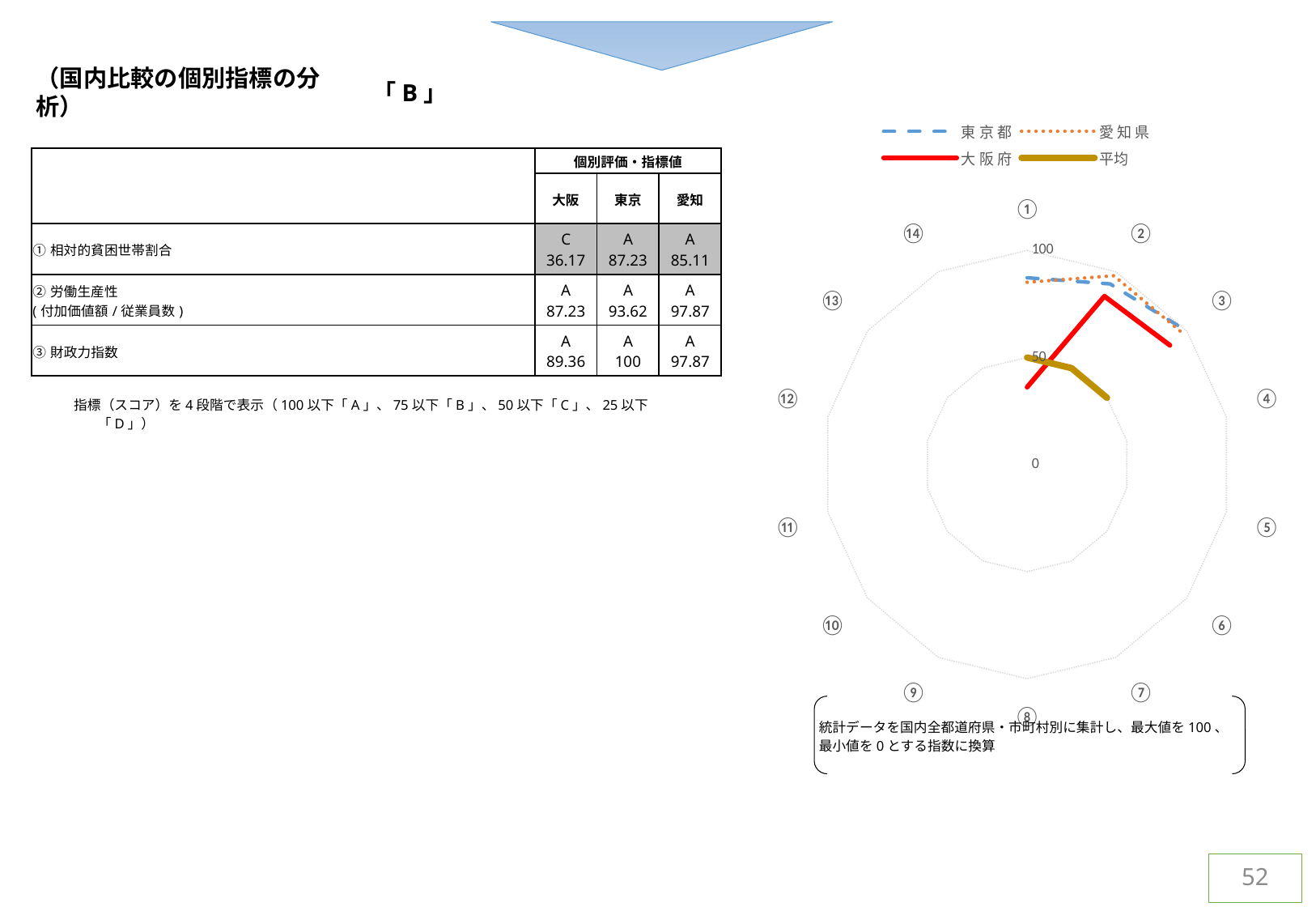
How many numbered axes (categories) does the radar chart have? 14 In the radar chart, which series has the larger value at axis ③: 東京都 or 大阪府? 東京都 What kind of chart is shown on the right side of the slide? radar chart In the radar chart, which series has the larger value at axis ②: 愛知県 or 大阪府? 愛知県 In the radar chart, is the value for 大阪府 at axis ① greater or less than 50? less What is the highest value labelled on the radar chart's scale? 100 In the radar chart, which series has the lowest value at axis ①? 大阪府 In the radar chart, is the value for 東京都 at axis ① greater or less than 50? greater Which series in the radar chart is drawn as a solid red line? 大阪府 In the radar chart, which series has the larger value at axis ①: 東京都 or 大阪府? 東京都 In the radar chart, is the value for 愛知県 at axis ③ greater or less than 50? greater How many series does the legend of the radar chart list? 4